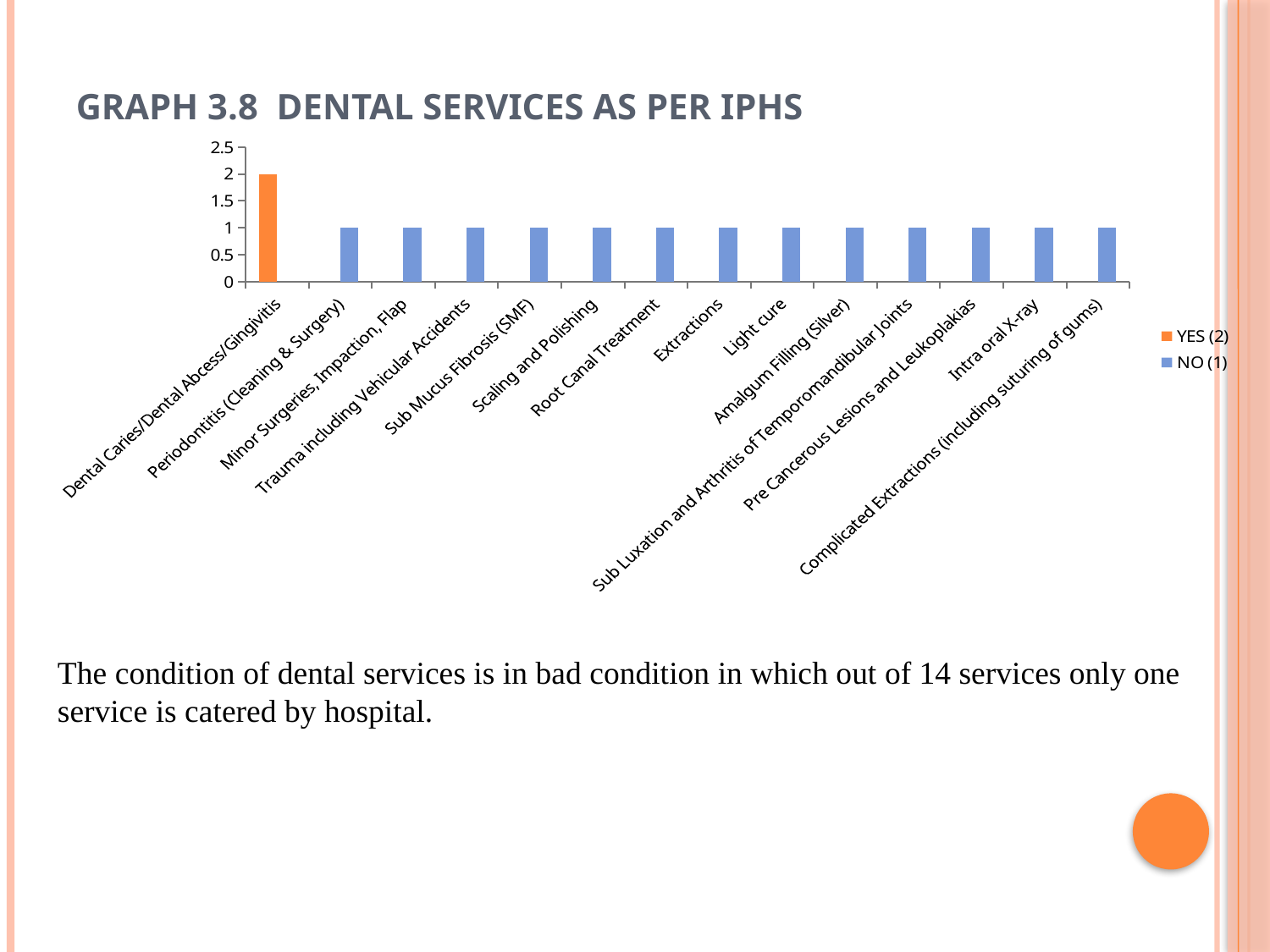
What type of chart is shown on the slide? Bar chart How many categories are shown on the x axis? 14 What is the value for Dental Caries/Dental Abcess/Gingivitis? 2 How many series does the legend list? 2 Is the value for Light cure greater or less than 1.5? less Which category has the highest value? Dental Caries/Dental Abcess/Gingivitis What is the value for Intra oral X-ray? 1 Which legend entry is shown in orange? YES (2) What is the difference between the value for Dental Caries/Dental Abcess/Gingivitis and the value for Extractions? 1 What is the value for Root Canal Treatment? 1 What is the title of the chart? GRAPH 3.8 DENTAL SERVICES AS PER IPHS Which is larger, the value for Dental Caries/Dental Abcess/Gingivitis or the value for Scaling and Polishing? Dental Caries/Dental Abcess/Gingivitis